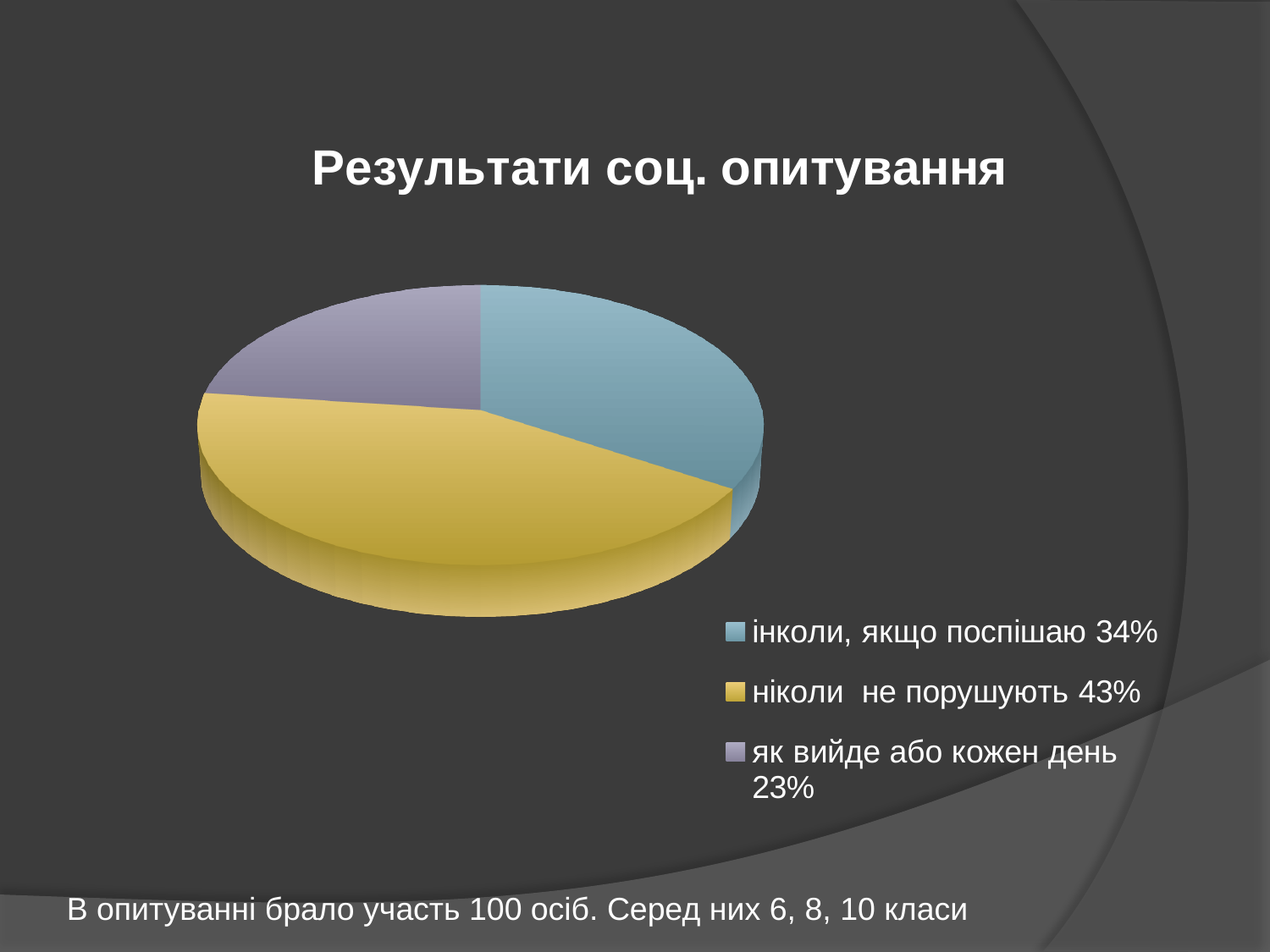
What percentage is shown for "ніколи не порушують"? 43% What kind of chart is shown on the slide? pie chart How many entries does the legend list? 3 What is the difference in percentage points between "ніколи не порушують" and "інколи, якщо поспішаю"? 9 Which category has the largest share of the pie? ніколи не порушують Which is larger: the share for "інколи, якщо поспішаю" or for "як вийде або кожен день"? інколи, якщо поспішаю What percentage is shown for "як вийде або кожен день"? 23% How many slices does the pie chart have? 3 Which category has the smallest share of the pie? як вийде або кожен день What is the title of the chart? Результати соц. опитування What colour is the slice for "ніколи не порушують"? yellow What percentage is shown for "інколи, якщо поспішаю"? 34%